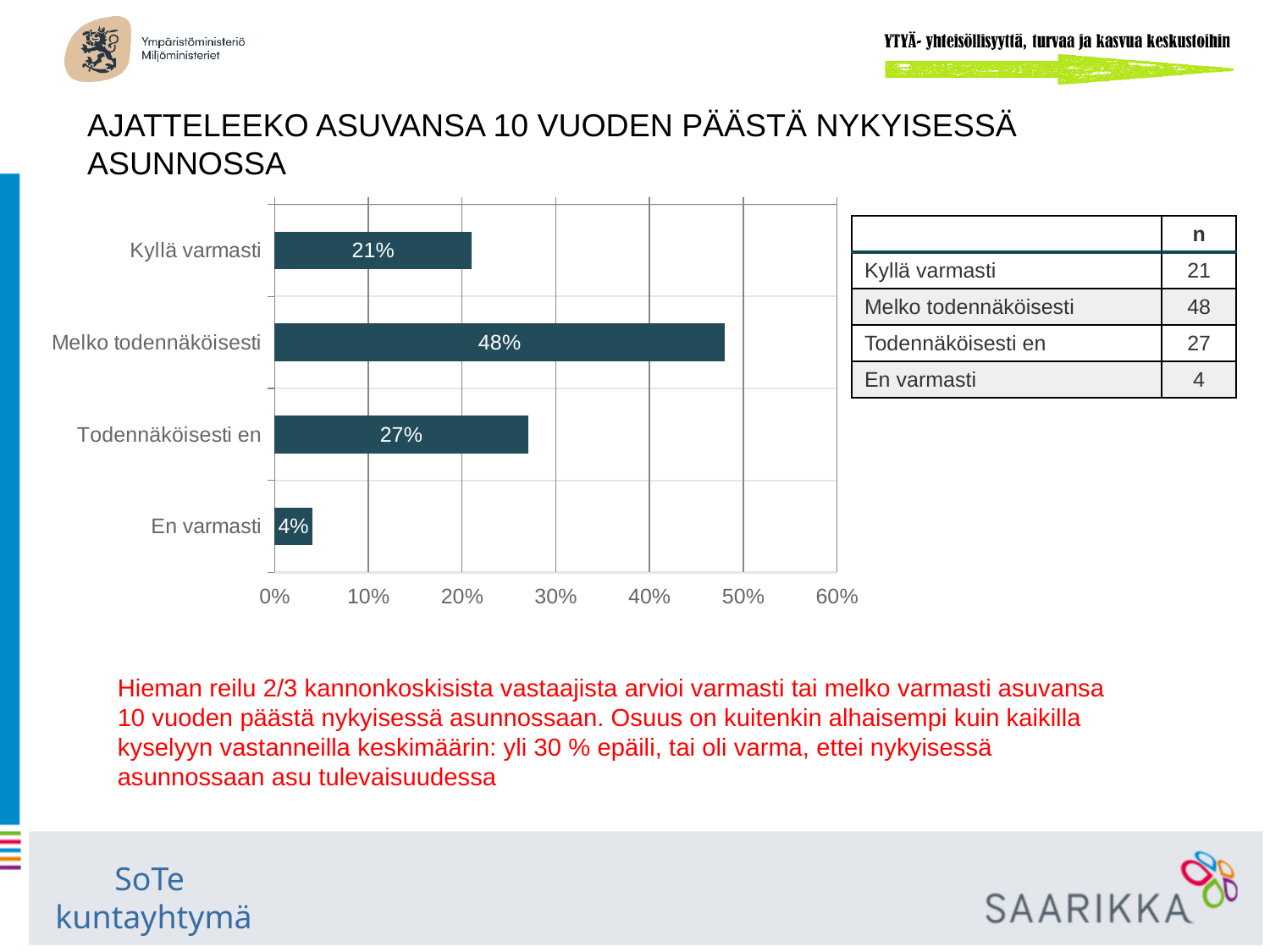
Which category has the lowest value? En varmasti What is the value for "Kyllä varmasti"? 21% What is the highest value shown on the x axis of the chart? 60% Is the value for "Melko todennäköisesti" greater or less than 40%? greater What is the value for "Melko todennäköisesti"? 48% What kind of chart is shown on the slide? bar chart What is the difference between the values for "Kyllä varmasti" and "En varmasti"? 17% What is the difference between the values for "Melko todennäköisesti" and "Todennäköisesti en"? 21% Which is larger, the value for "Kyllä varmasti" or the value for "Todennäköisesti en"? Todennäköisesti en How many categories are shown in the chart? 4 What is the value for "En varmasti"? 4% Which category has the highest value? Melko todennäköisesti